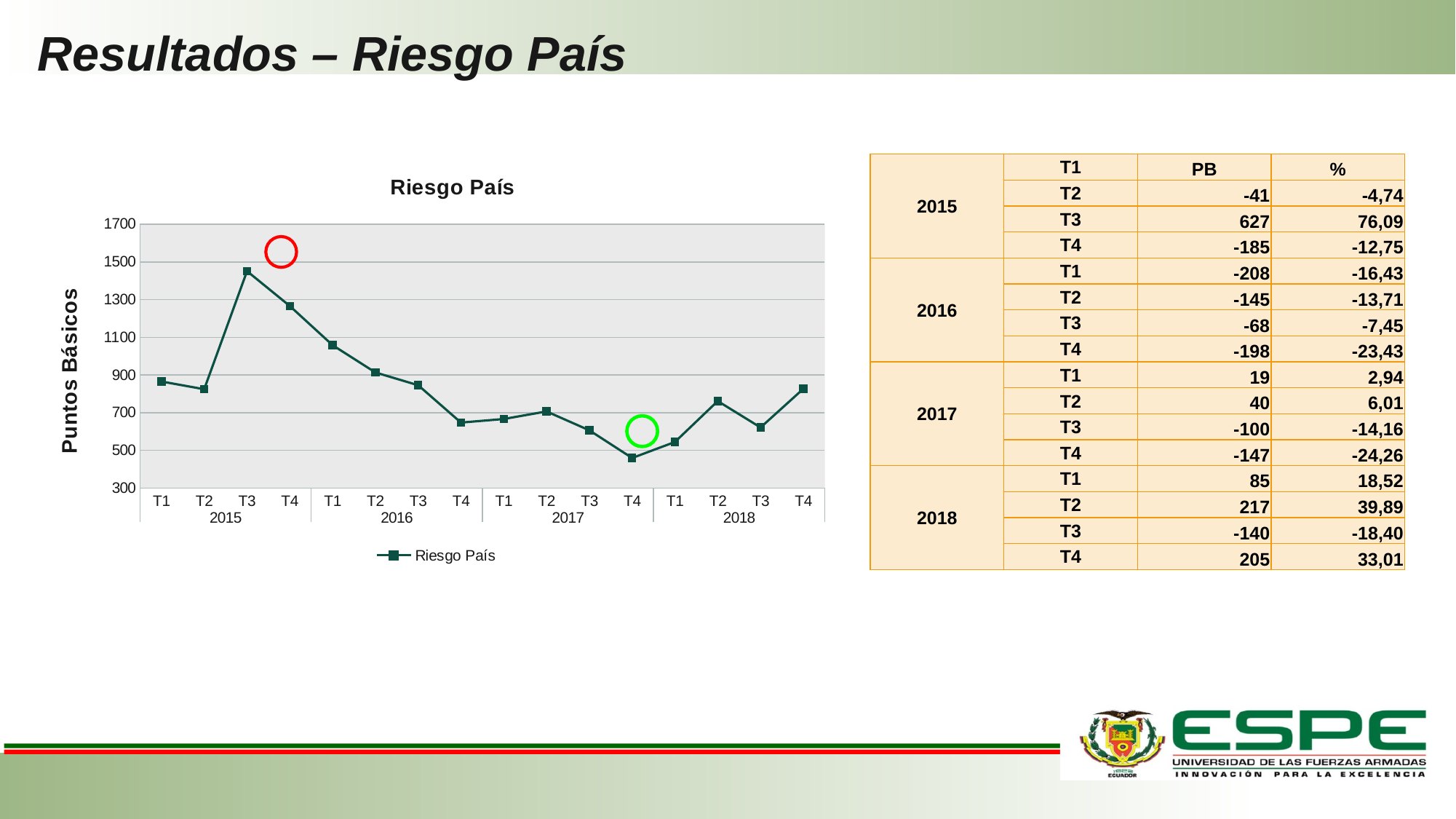
Do the values on the "Riesgo País" chart rise or fall from T3 2015 to T4 2016? fall How many series does the legend of the "Riesgo País" chart list? 1 What kind of chart is the "Riesgo País" chart? line chart Which quarter has the lowest value on the "Riesgo País" chart? T4 2017 Which quarter has the highest value on the "Riesgo País" chart? T3 2015 Is the value for T1 2016 greater or less than 900? greater Which is larger on the "Riesgo País" chart, the value for T1 2018 or T2 2018? T2 2018 Is the value for T3 2015 greater or less than 1300? greater What is the name of the series shown in the legend of the chart? Riesgo País Is the value for T4 2017 greater or less than 500? less What is the title of the vertical axis on the "Riesgo País" chart? Puntos Básicos How many data points are plotted on the "Riesgo País" chart? 16